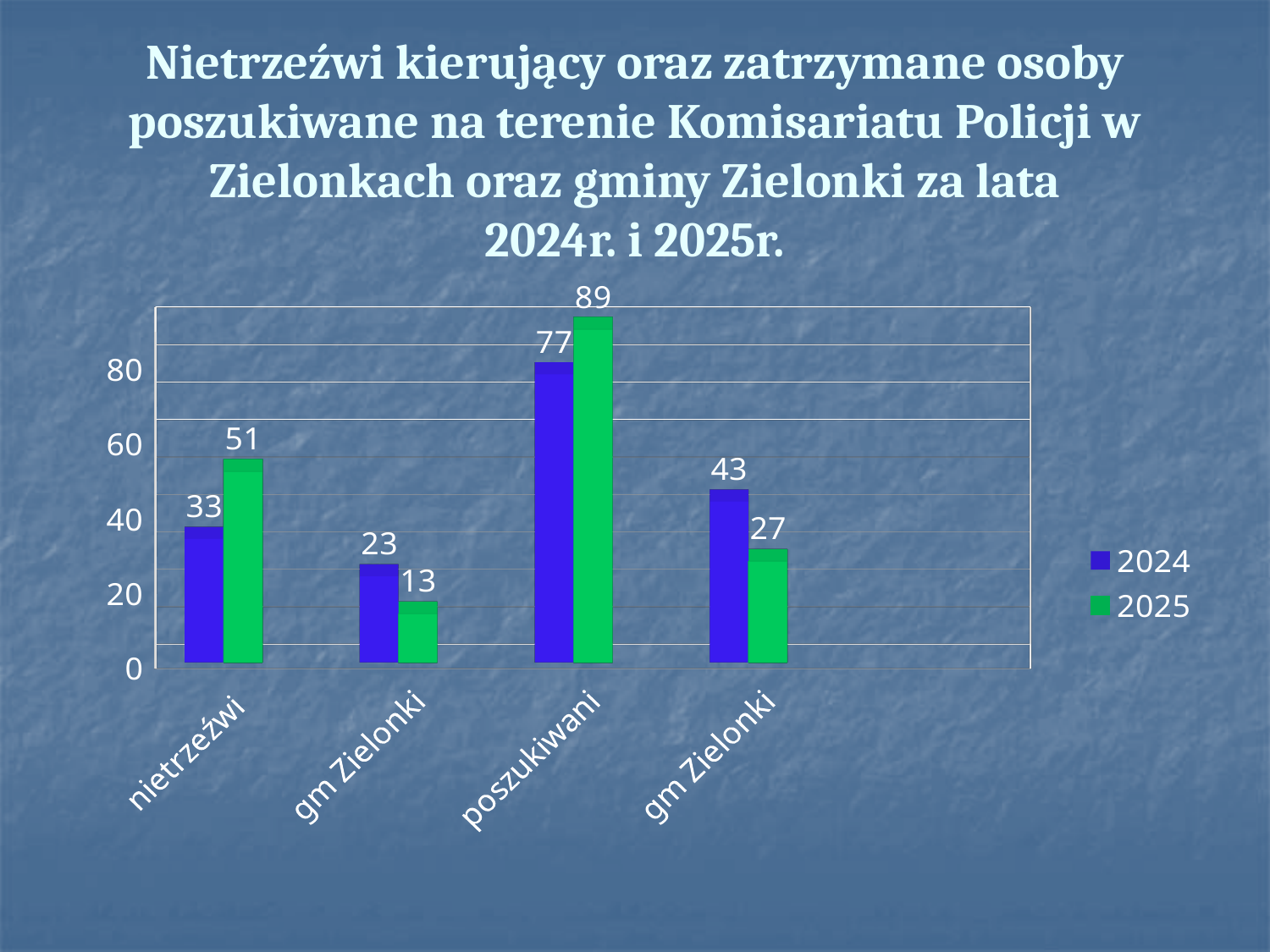
What is the 2025 value for the first gm Zielonki category (the one right after nietrzeźwi)? 13 Which category has the highest 2025 value? poszukiwani What is the 2024 value for the second gm Zielonki category (the one right after poszukiwani)? 43 How many series does the legend list? 2 What is the 2024 value for nietrzeźwi? 33 For the second gm Zielonki category (after poszukiwani), which year has the larger value, 2024 or 2025? 2024 Which category has the lowest 2024 value? gm Zielonki (the first one, after nietrzeźwi) What is the difference between the 2025 and 2024 values for nietrzeźwi? 18 What is the difference between the 2025 and 2024 values for poszukiwani? 12 What kind of chart is shown on the slide? bar chart What is the 2025 value for poszukiwani? 89 How many categories are shown on the x axis? 4